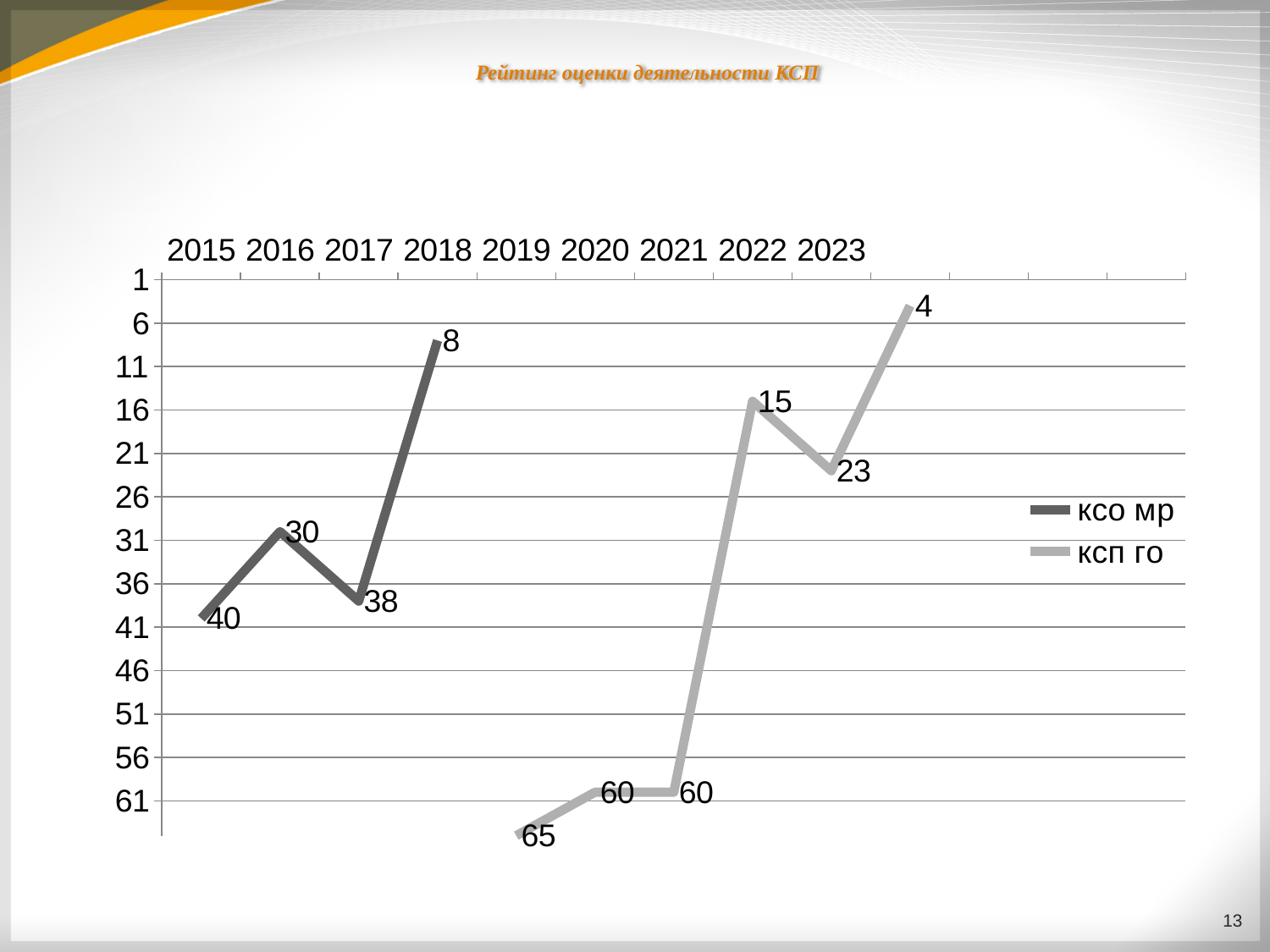
What is the value for ксо мр in 2015? 40 What is the value for ксо мр in 2018? 8 What is the value for ксп го in 2020? 60 What is the value for ксп го in 2019? 65 What is the value for ксп го in 2023? 23 What is the value for ксп го in 2022? 15 What kind of chart is shown on the slide? Line chart Which year has the larger ксо мр value, 2016 or 2017? 2017 In which year does the ксо мр series have its largest labeled value? 2015 What is the difference between the ксп го values for 2019 and 2020? 5 How many series does the legend list? 2 What is the difference between the ксо мр values for 2017 and 2016? 8